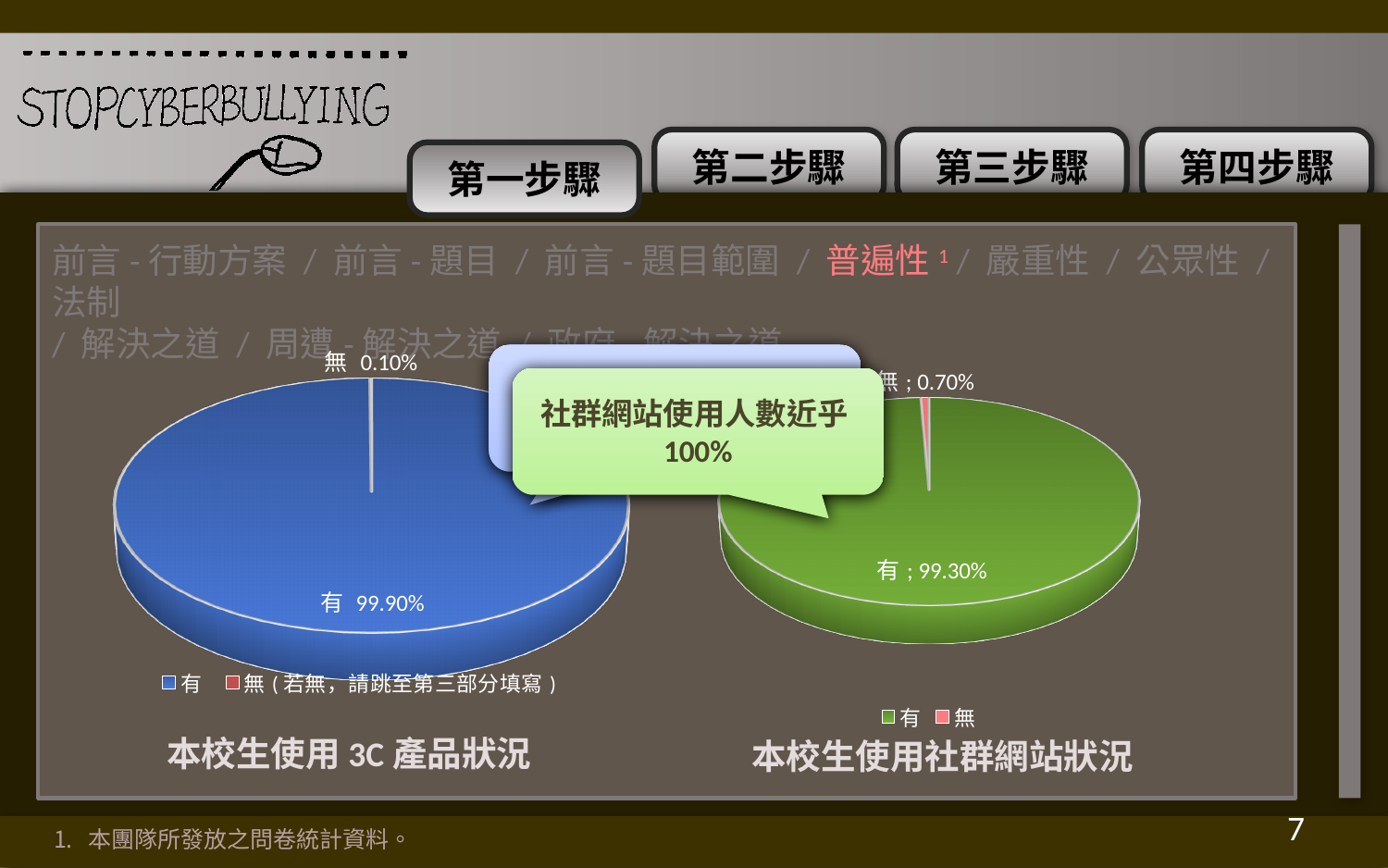
What colour is the 有 slice in the chart titled 本校生使用社群網站狀況? Green In the chart titled 本校生使用 3C 產品狀況, what percentage is shown for 有? 99.90% How many entries does the legend of the chart titled 本校生使用社群網站狀況 list? 2 In the chart titled 本校生使用 3C 產品狀況, which category has the largest slice? 有 In the chart titled 本校生使用社群網站狀況, which category has the smallest slice? 無 What type of chart is the one titled 本校生使用社群網站狀況? Pie chart In the chart titled 本校生使用社群網站狀況, what percentage is shown for 有? 99.30% What is the difference between the 有 value in the 本校生使用 3C 產品狀況 chart and the 有 value in the 本校生使用社群網站狀況 chart? 0.60% In the chart titled 本校生使用 3C 產品狀況, what percentage is shown for 無? 0.10% In the chart titled 本校生使用社群網站狀況, what percentage is shown for 無? 0.70% How many slices does the chart titled 本校生使用 3C 產品狀況 have? 2 Which is larger: the 無 value in the 本校生使用 3C 產品狀況 chart or the 無 value in the 本校生使用社群網站狀況 chart? 本校生使用社群網站狀況